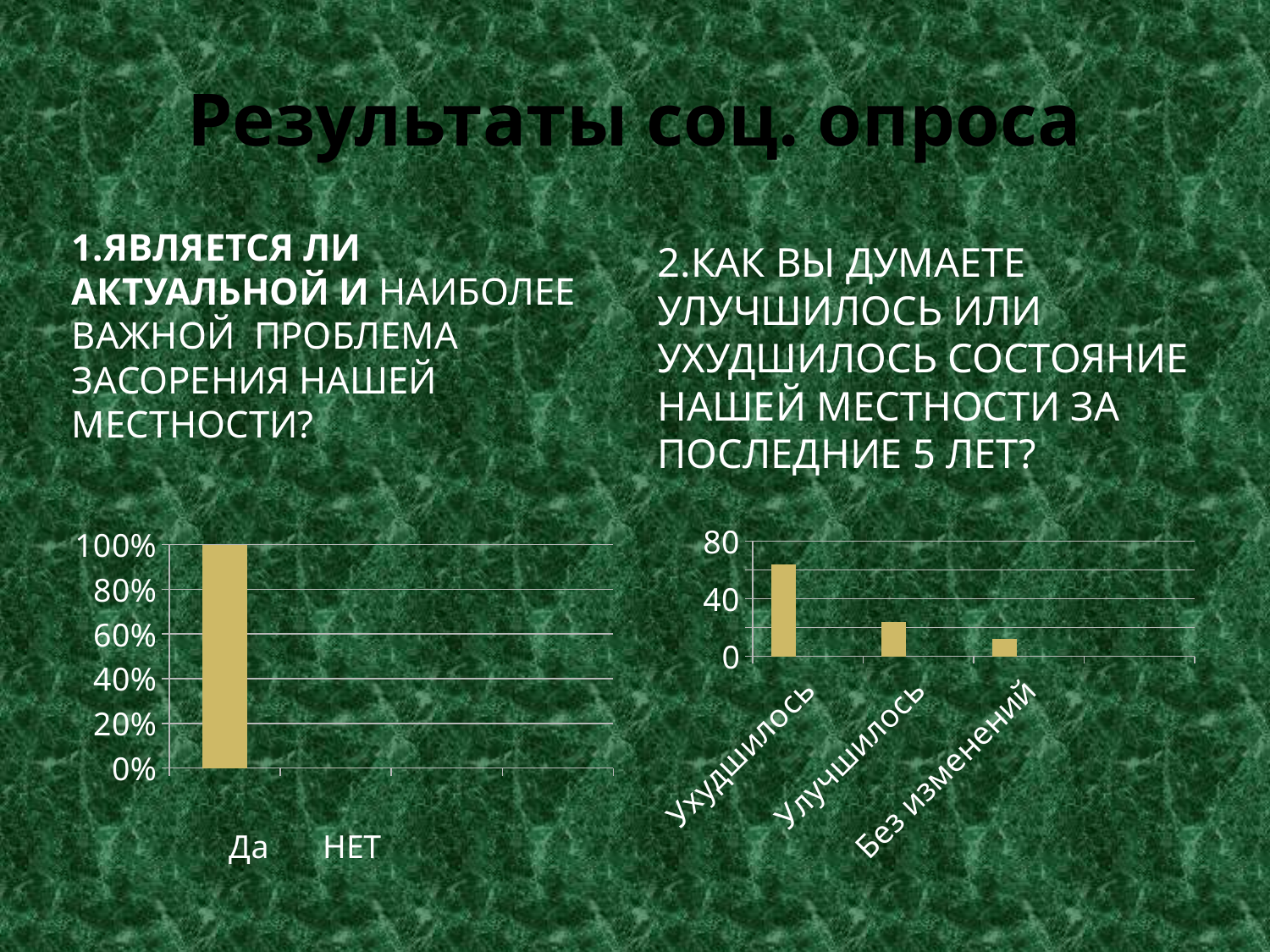
In the right chart (question 2), do the values rise or fall from left to right? fall What kind of chart is the left chart (question 1)? bar chart In the right chart (question 2), is the value for Без изменений greater or less than 40? less How many categories are shown in the right chart (question 2)? 3 In the left chart (question 1), what value does the bar for Да reach? 100% In the right chart (question 2), is the value for Ухудшилось greater or less than 40? greater In the right chart (question 2), which is larger: Ухудшилось or Улучшилось? Ухудшилось In the left chart (question 1), is the value for Да greater or less than 80%? greater What kind of chart is the right chart (question 2)? bar chart In the right chart (question 2), which category has the lowest value? Без изменений In the right chart (question 2), which category has the highest value? Ухудшилось